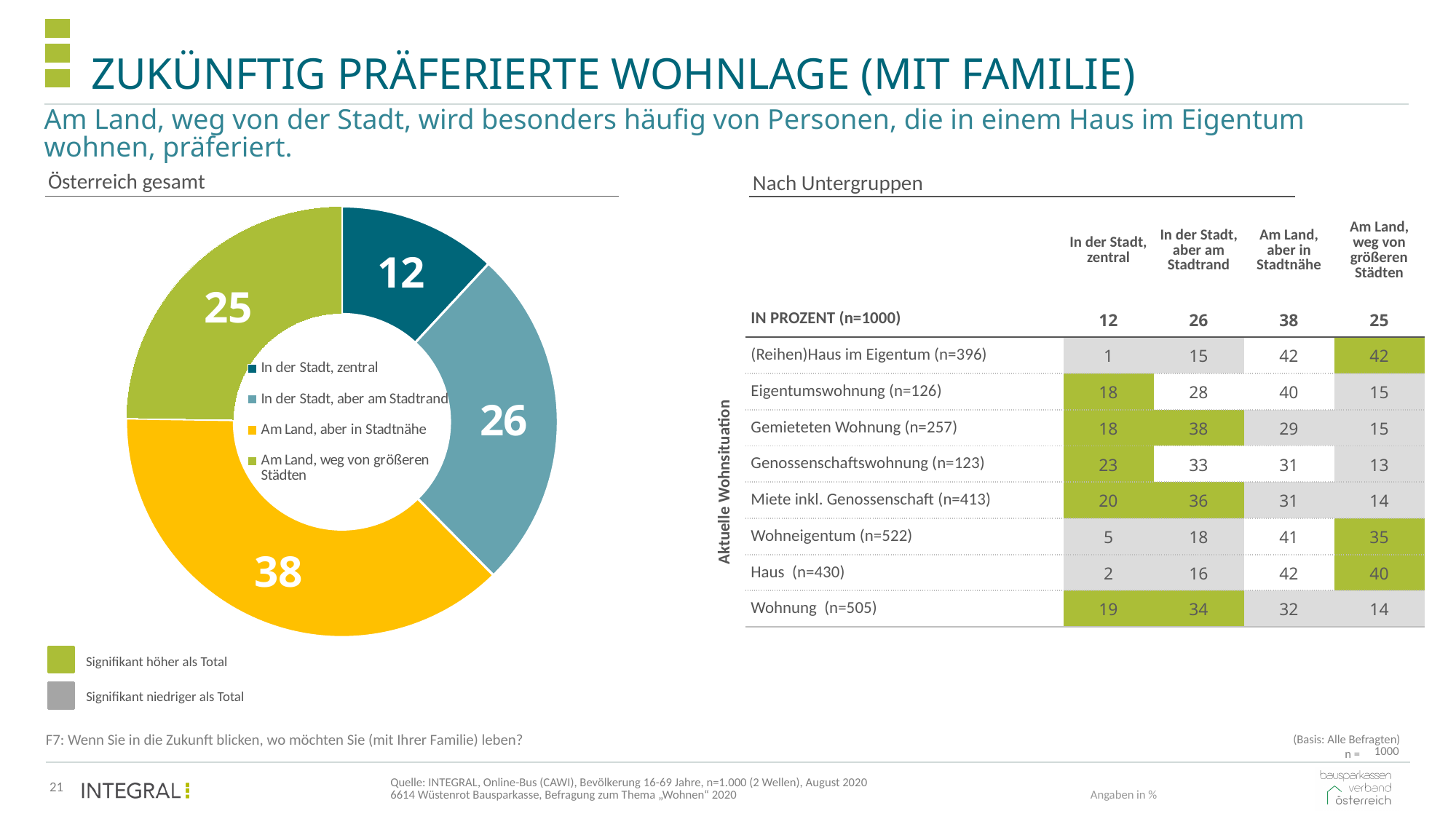
In the 'Österreich gesamt' chart, what is the value for 'Am Land, aber in Stadtnähe'? 38 In the 'Österreich gesamt' chart, which category has the smallest slice? In der Stadt, zentral In the 'Österreich gesamt' chart, what is the difference between the values for 'In der Stadt, aber am Stadtrand' and 'Am Land, weg von größeren Städten'? 1 In the 'Österreich gesamt' chart, what is the value for 'In der Stadt, aber am Stadtrand'? 26 In the 'Österreich gesamt' chart, which category has the largest slice? Am Land, aber in Stadtnähe In the 'Österreich gesamt' chart, what is the value for 'In der Stadt, zentral'? 12 In the 'Österreich gesamt' chart, what is the value for 'Am Land, weg von größeren Städten'? 25 How many categories does the 'Österreich gesamt' chart show? 4 In the 'Österreich gesamt' chart, what is the difference between the values for 'Am Land, aber in Stadtnähe' and 'In der Stadt, zentral'? 26 What kind of chart is the 'Österreich gesamt' chart? pie chart (donut) In the 'Österreich gesamt' chart, which is larger: 'Am Land, aber in Stadtnähe' or 'In der Stadt, aber am Stadtrand'? Am Land, aber in Stadtnähe In the 'Österreich gesamt' chart, what colour is the slice for 'Am Land, aber in Stadtnähe'? yellow